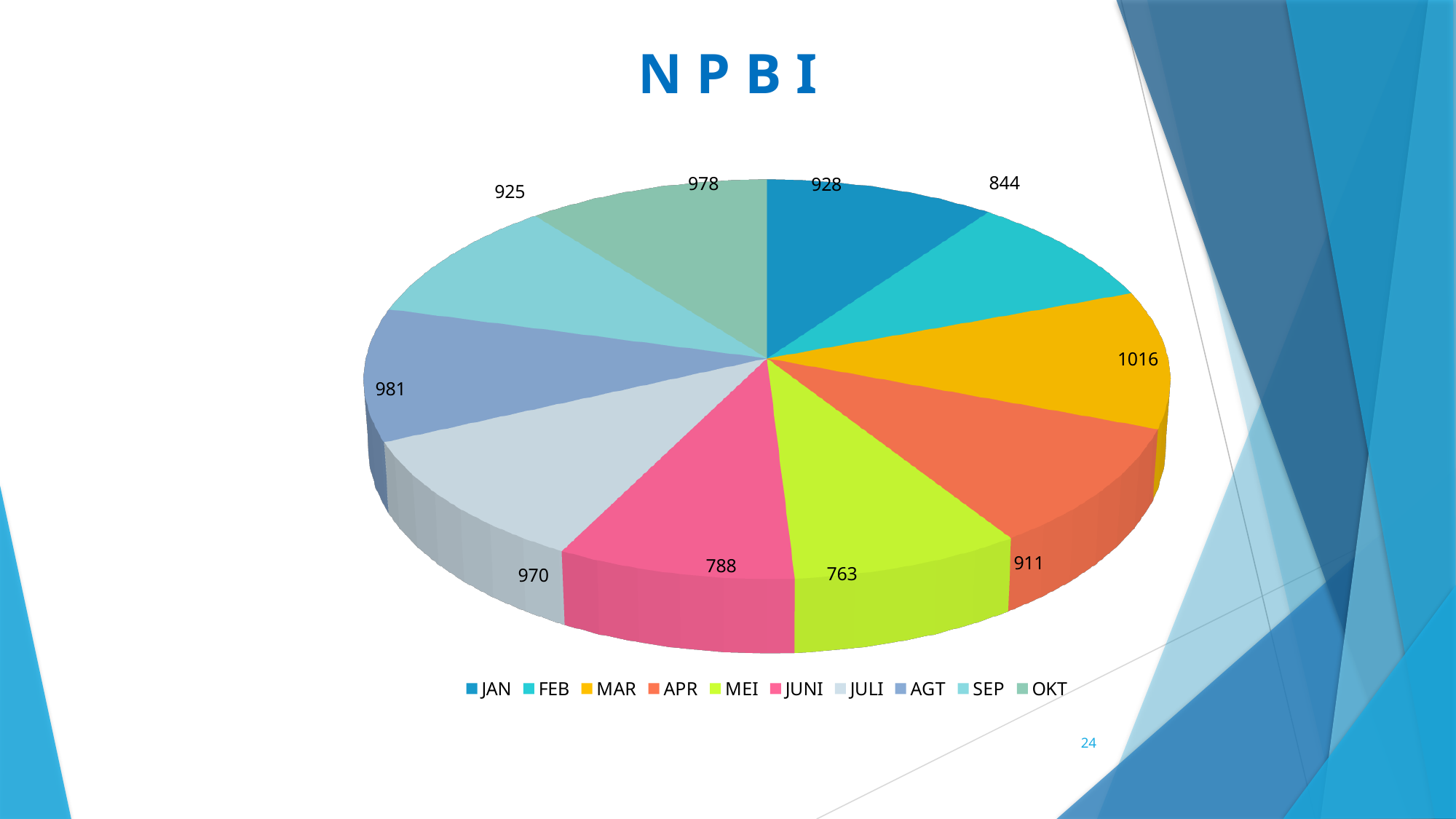
How many entries does the legend list? 10 Which is larger, the value for AGT or the value for JULI? AGT Which month has the lowest value? MEI Which month has the highest value? MAR What is the value for MAR? 1016 How many slices does the pie chart have? 10 What is the title of the chart? NPBI What is the difference between the values for MAR and MEI? 253 What is the value for JUNI? 788 What type of chart is shown on the slide? pie chart What is the value for SEP? 925 What is the difference between the values for JAN and FEB? 84